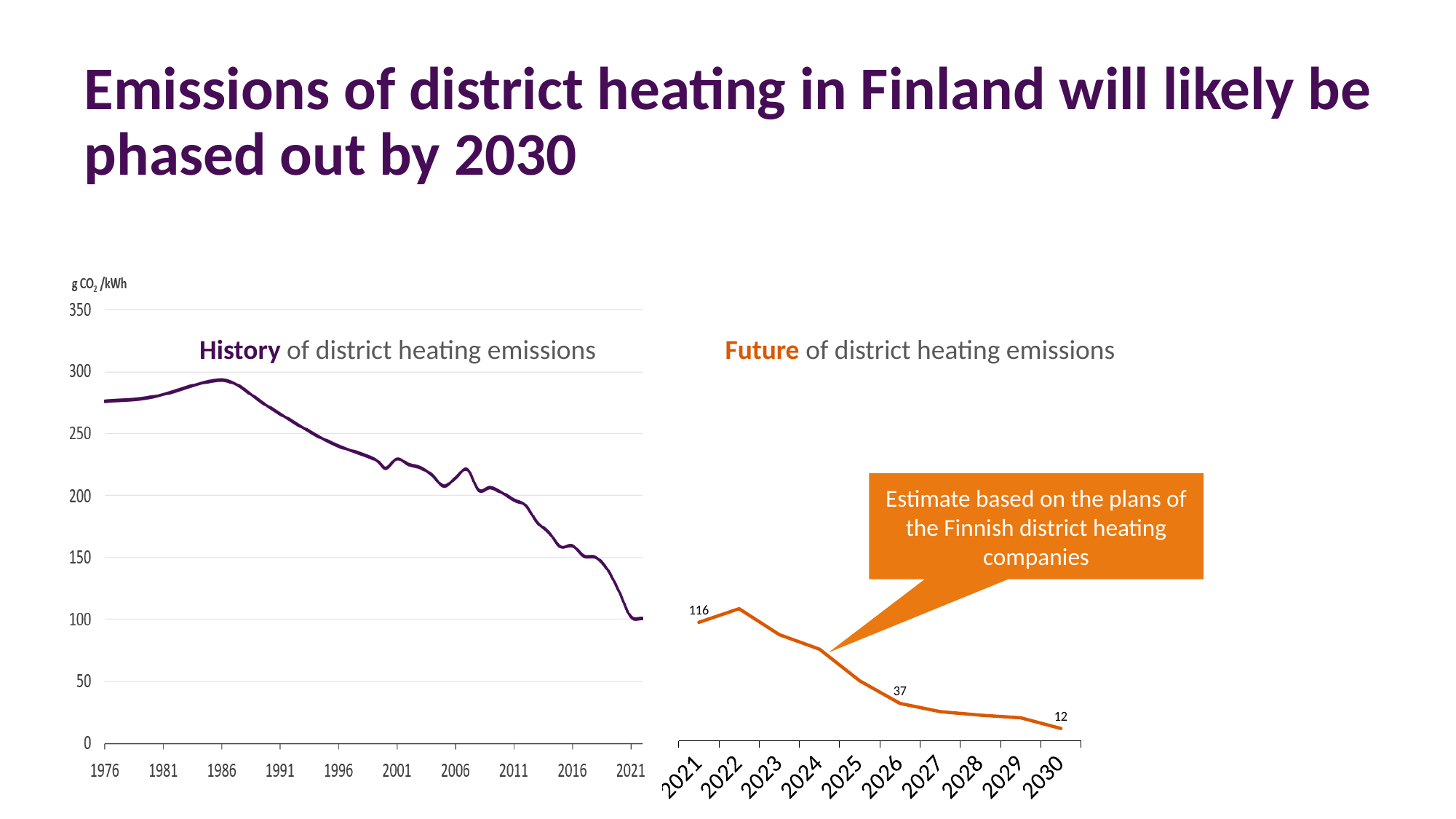
In the 'Future of district heating emissions' chart, what is the difference between the 2021 value and the 2030 value? 104 In the 'History of district heating emissions' chart, do the values generally rise or fall from 1986 to 2021? fall How many years are shown on the x axis of the 'Future of district heating emissions' chart? 10 In the 'History of district heating emissions' chart, is the value for 2021 greater or less than 150? less In the 'Future of district heating emissions' chart, what is the value for 2030? 12 What unit is shown on the y axis of the 'History of district heating emissions' chart? g CO2 /kWh In the 'Future of district heating emissions' chart, what is the difference between the 2026 value and the 2030 value? 25 In the 'History of district heating emissions' chart, is the value for 1986 greater or less than 250? greater In the 'Future of district heating emissions' chart, which year has the lowest value? 2030 In the 'Future of district heating emissions' chart, what is the value for 2021? 116 In the 'Future of district heating emissions' chart, what is the value for 2026? 37 What type of chart is the 'History of district heating emissions' chart? line chart